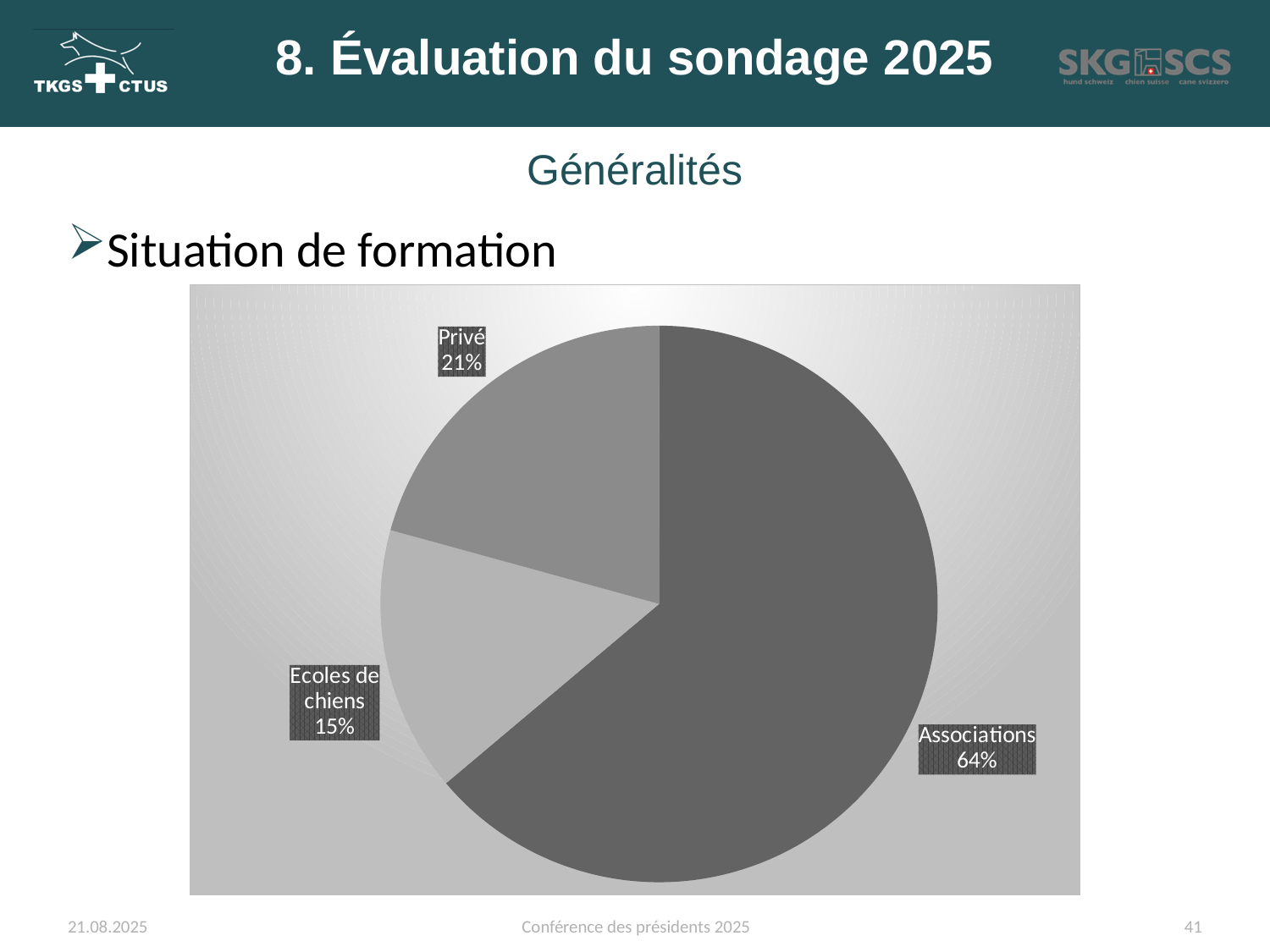
What is the bullet-point heading above the chart? Situation de formation What kind of chart is shown on the slide? pie chart What is the difference in percentage points between Privé and Ecoles de chiens? 6 What share of the pie does Associations have? 64% Which is larger, the share for Associations or the share for Privé? Associations Which category has the largest slice of the pie? Associations Which is larger, the share for Privé or the share for Ecoles de chiens? Privé How many slices does the pie chart have? 3 What share of the pie does Privé have? 21% What share of the pie does Ecoles de chiens have? 15% What is the difference in percentage points between Associations and Privé? 43 Which category has the smallest slice of the pie? Ecoles de chiens